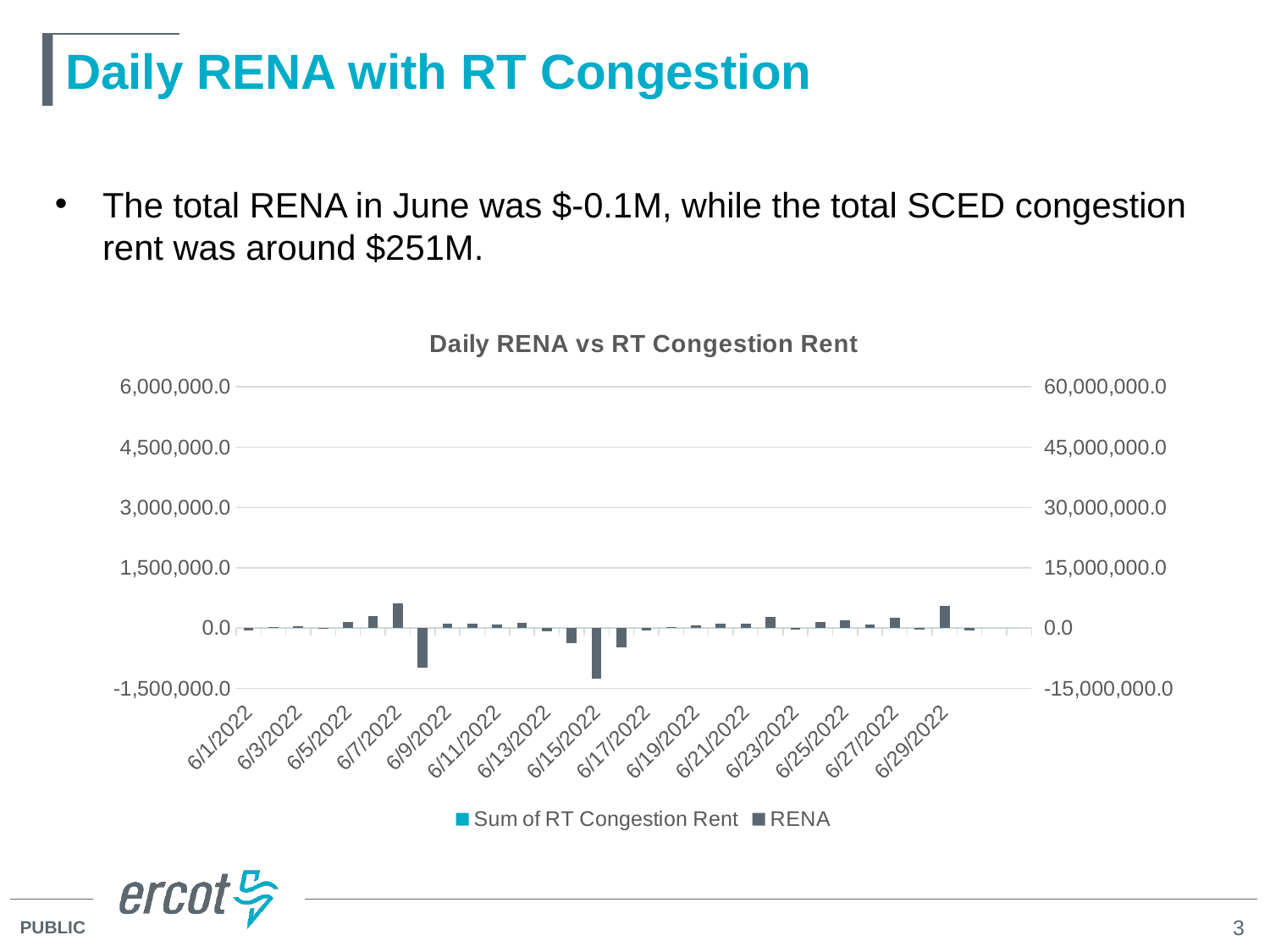
What are the two series named in the chart legend? Sum of RT Congestion Rent and RENA On which date is the RENA value lowest? 6/15/2022 Which has the larger RENA value, 6/9/2022 or 6/15/2022? 6/9/2022 How many date labels are shown on the x axis of the chart? 15 How many series does the chart legend list? 2 Is the RENA value for 6/9/2022 greater or less than 0.0? greater What is the title of the chart? Daily RENA vs RT Congestion Rent Is the RENA value for 6/15/2022 greater or less than 0.0? less Is the RENA value for 6/7/2022 greater or less than 0.0? greater Which has the larger RENA value, 6/7/2022 or 6/9/2022? 6/7/2022 What type of chart is shown on the slide? bar chart